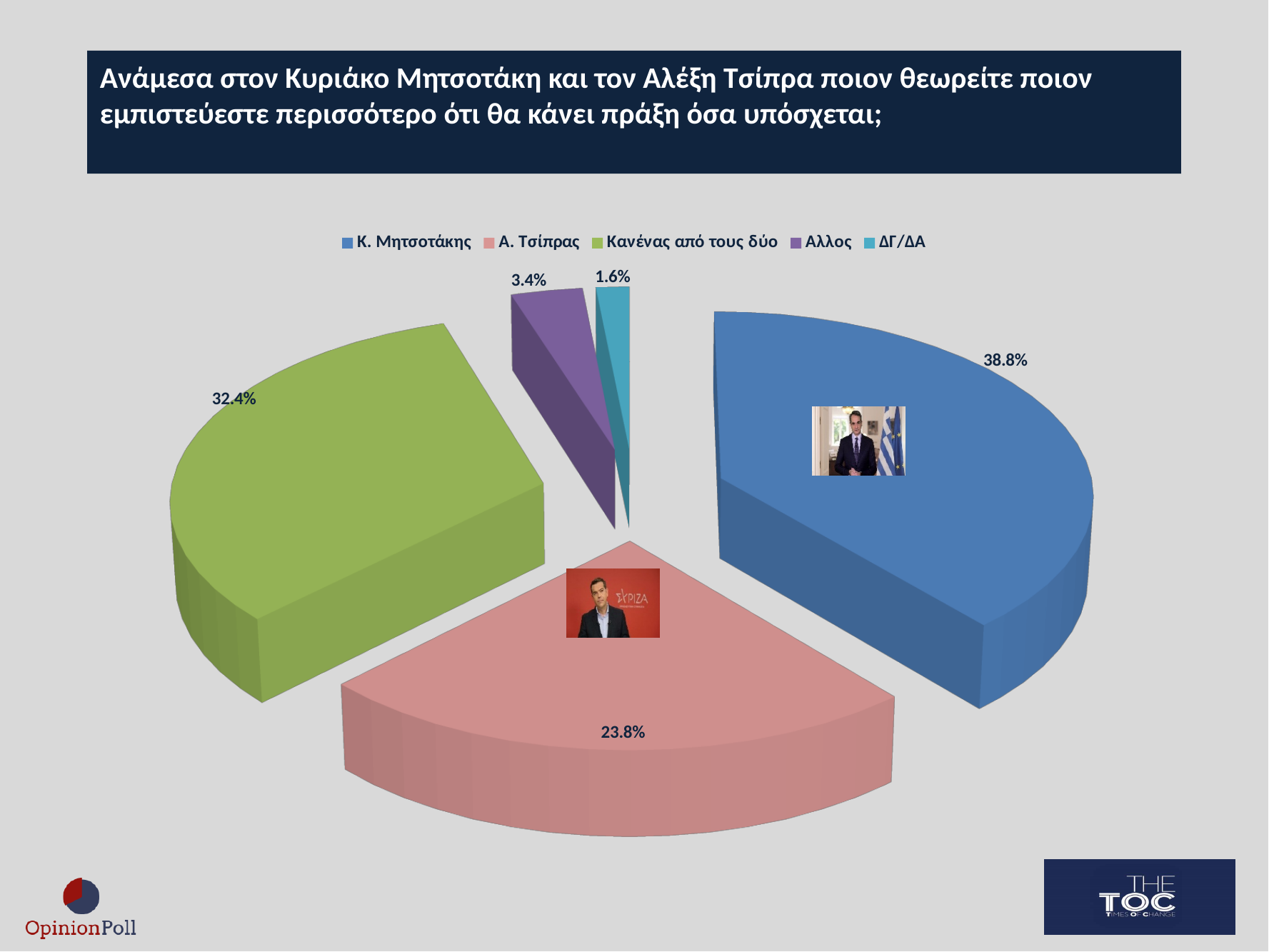
How many categories does the pie chart show? 5 What percentage of respondents chose Κ. Μητσοτάκης? 38.8% What kind of chart is shown on the slide? Pie chart Which is larger, the share for Κανένας από τους δύο or the share for Α. Τσίπρας? Κανένας από τους δύο What percentage of respondents answered Κανένας από τους δύο? 32.4% What colour is the slice for Κανένας από τους δύο? Green Which category has the largest share of the pie? Κ. Μητσοτάκης Which category has the smallest share of the pie? ΔΓ/ΔΑ What percentage of respondents answered Άλλος? 3.4% What percentage of respondents chose Α. Τσίπρας? 23.8% What percentage of respondents answered ΔΓ/ΔΑ? 1.6% What is the difference in percentage points between Κ. Μητσοτάκης and Α. Τσίπρας? 15 percentage points